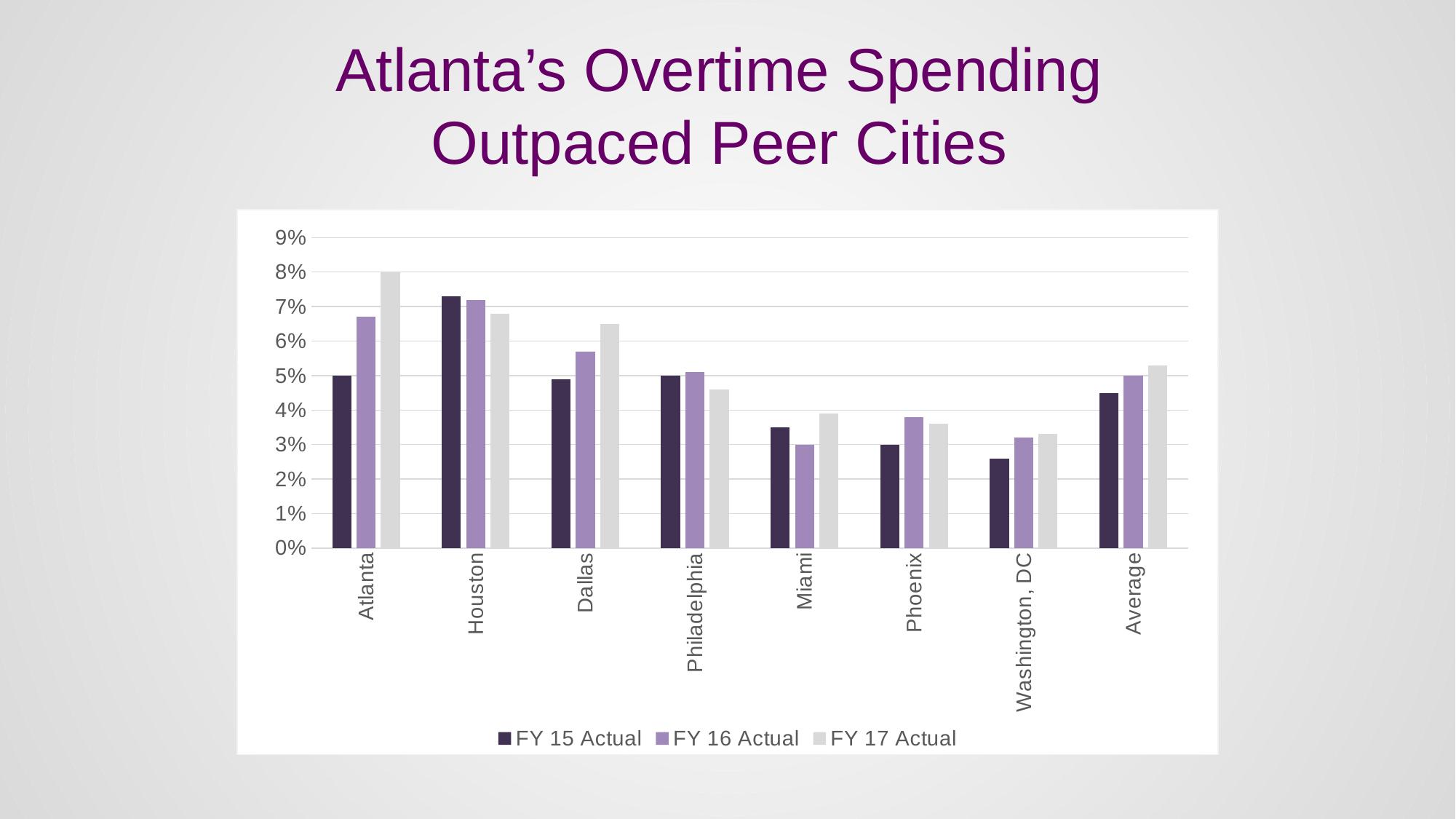
Which category has the lowest FY 15 Actual value? Washington, DC What is the FY 15 Actual value for Atlanta? 5% What is the FY 16 Actual value for Miami? 3% How many series does the legend list? 3 How many cities/categories are shown on the x axis? 8 Do Atlanta's values rise or fall from FY 15 Actual to FY 17 Actual? rise Which city has the highest FY 17 Actual value? Atlanta Which is larger, the FY 17 Actual value for Atlanta or for Houston? Atlanta What is the FY 17 Actual value for Atlanta? 8% Is the FY 17 Actual value for Philadelphia greater or less than 5%? less Is the FY 15 Actual value for Houston greater or less than 7%? greater What type of chart is shown on the slide? bar chart